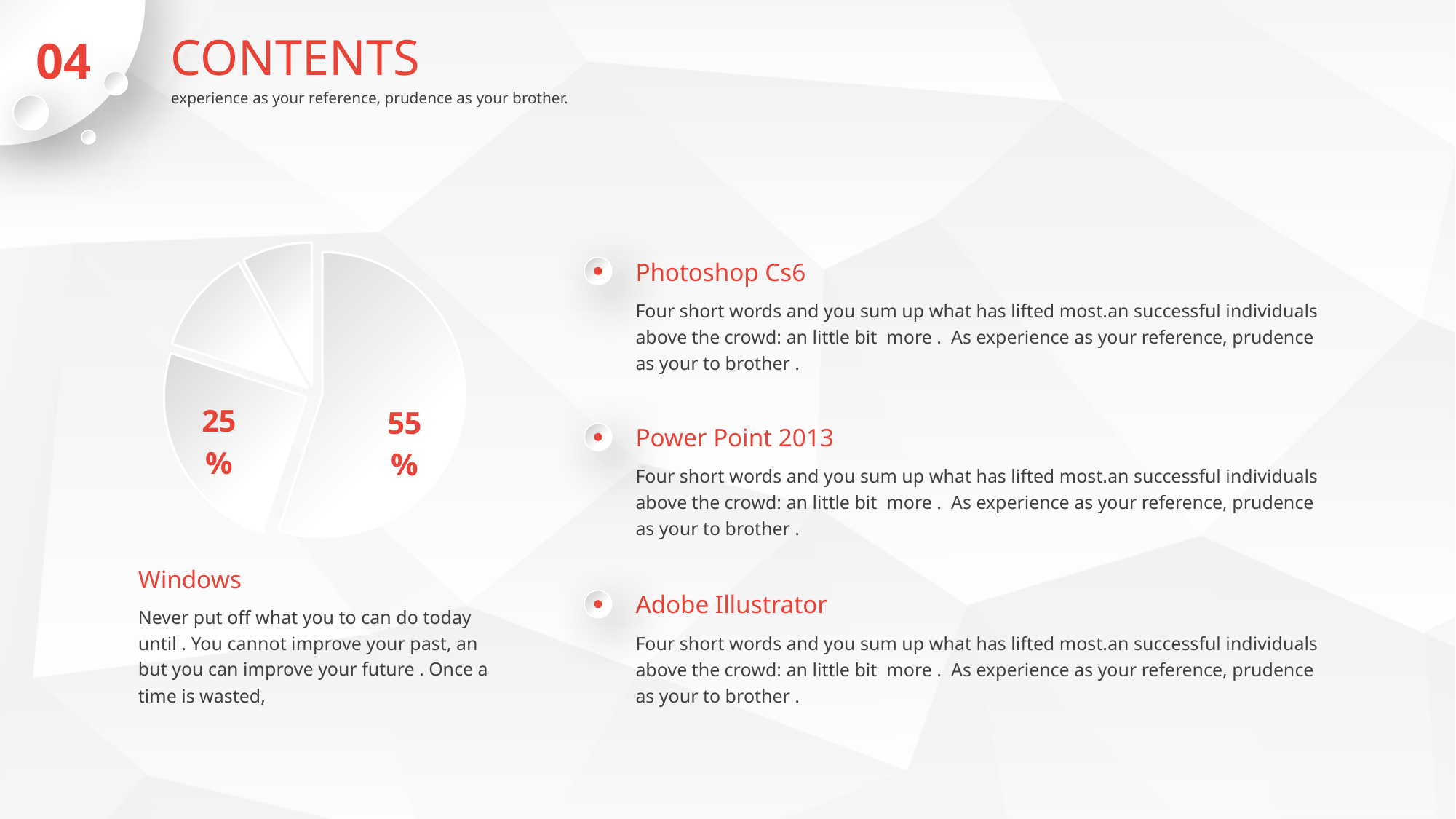
What is the value printed on the largest slice of the pie chart? 55% Does the largest slice of the pie chart account for more or less than half of the pie? more How many slices of the pie chart have a percentage label printed on them? 2 What kind of chart is shown on the slide? pie chart What is the difference between the two labelled slices of the pie chart, 55% and 25%? 30% Does the pie chart have a legend? No What colour are the percentage labels on the pie chart? red What is the value printed on the slice on the left side of the pie chart? 25% How many slices does the pie chart have? 4 Which labelled slice of the pie chart is larger, the one marked 55% or the one marked 25%? 55%